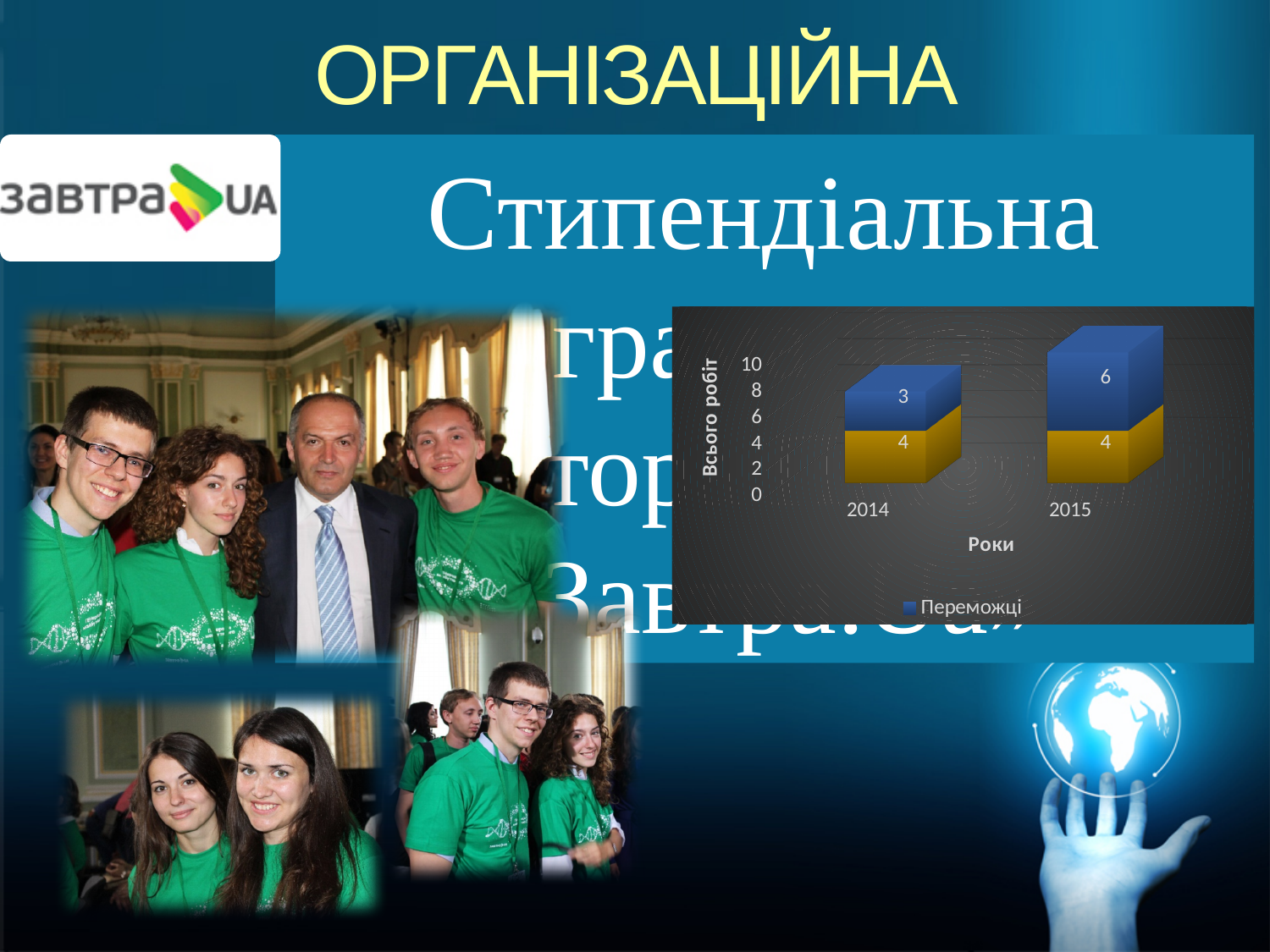
What kind of chart is shown on the slide? bar chart Does the Переможці value rise or fall from 2014 to 2015? rise What is the value of the bottom (gold) segment of the bar for 2014? 4 What is the value of the Переможці series for 2014? 3 What is the value of the Переможці series for 2015? 6 What is the total of the stacked bar for 2014? 7 By how much did the Переможці value increase from 2014 to 2015? 3 What is the total of the stacked bar for 2015? 10 What is the value of the bottom (gold) segment of the bar for 2015? 4 What is the title of the x axis of the chart? Роки Which year has the larger Переможці value, 2014 or 2015? 2015 How many years are shown on the x axis of the chart? 2